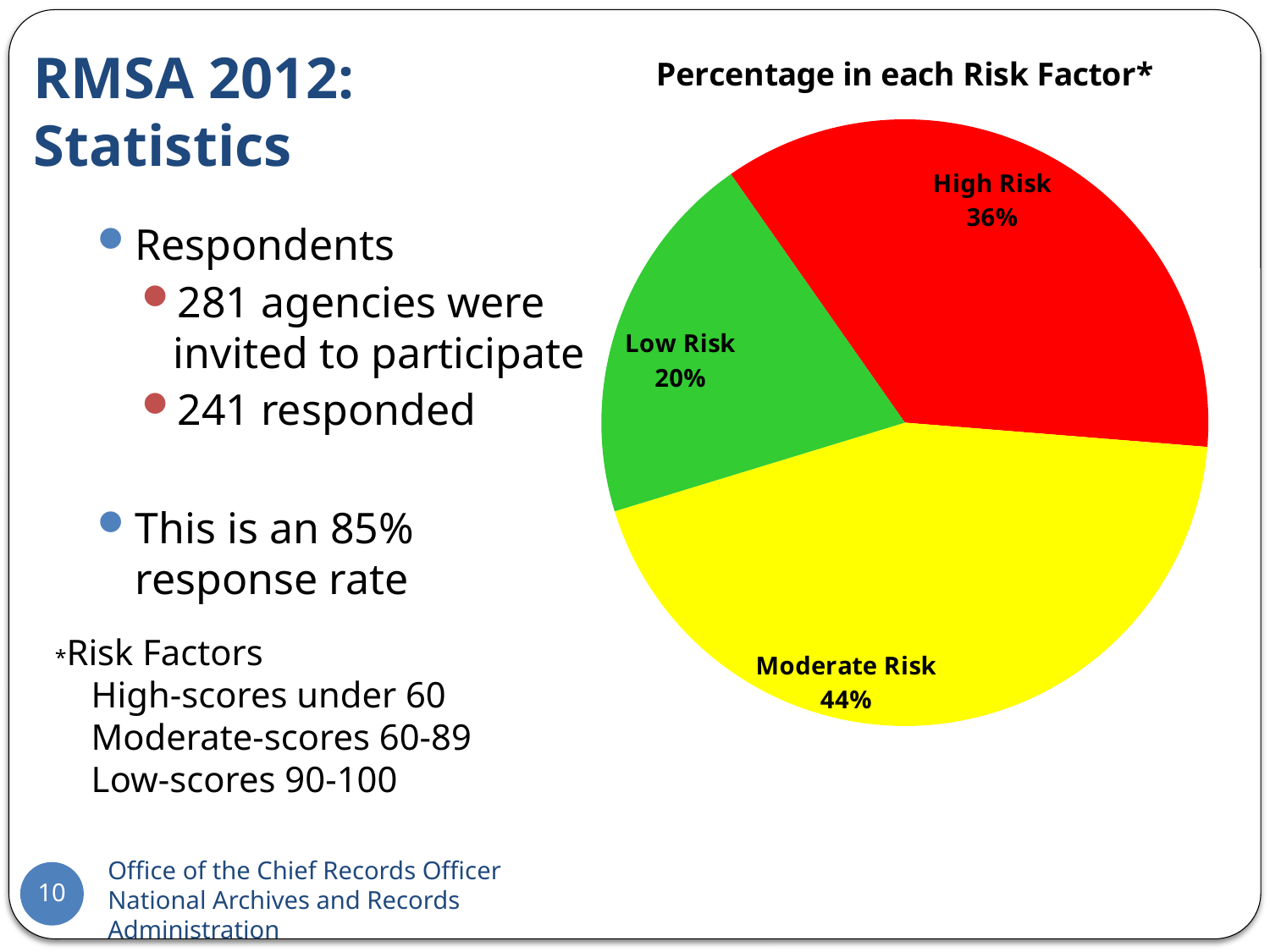
How many slices does the pie chart have? 3 What kind of chart is shown on the slide? Pie chart What is the difference in percentage points between the High Risk and Low Risk slices? 16 What is the difference in percentage points between the Moderate Risk and High Risk slices? 8 What is the title of the chart? Percentage in each Risk Factor* What percentage of the pie is labelled Low Risk? 20% What percentage of the pie is labelled High Risk? 36% What colour is the Moderate Risk slice? Yellow Which risk factor has the largest share of the pie? Moderate Risk What percentage of the pie is labelled Moderate Risk? 44% Which risk factor has the smallest share of the pie? Low Risk Which slice is larger, High Risk or Low Risk? High Risk